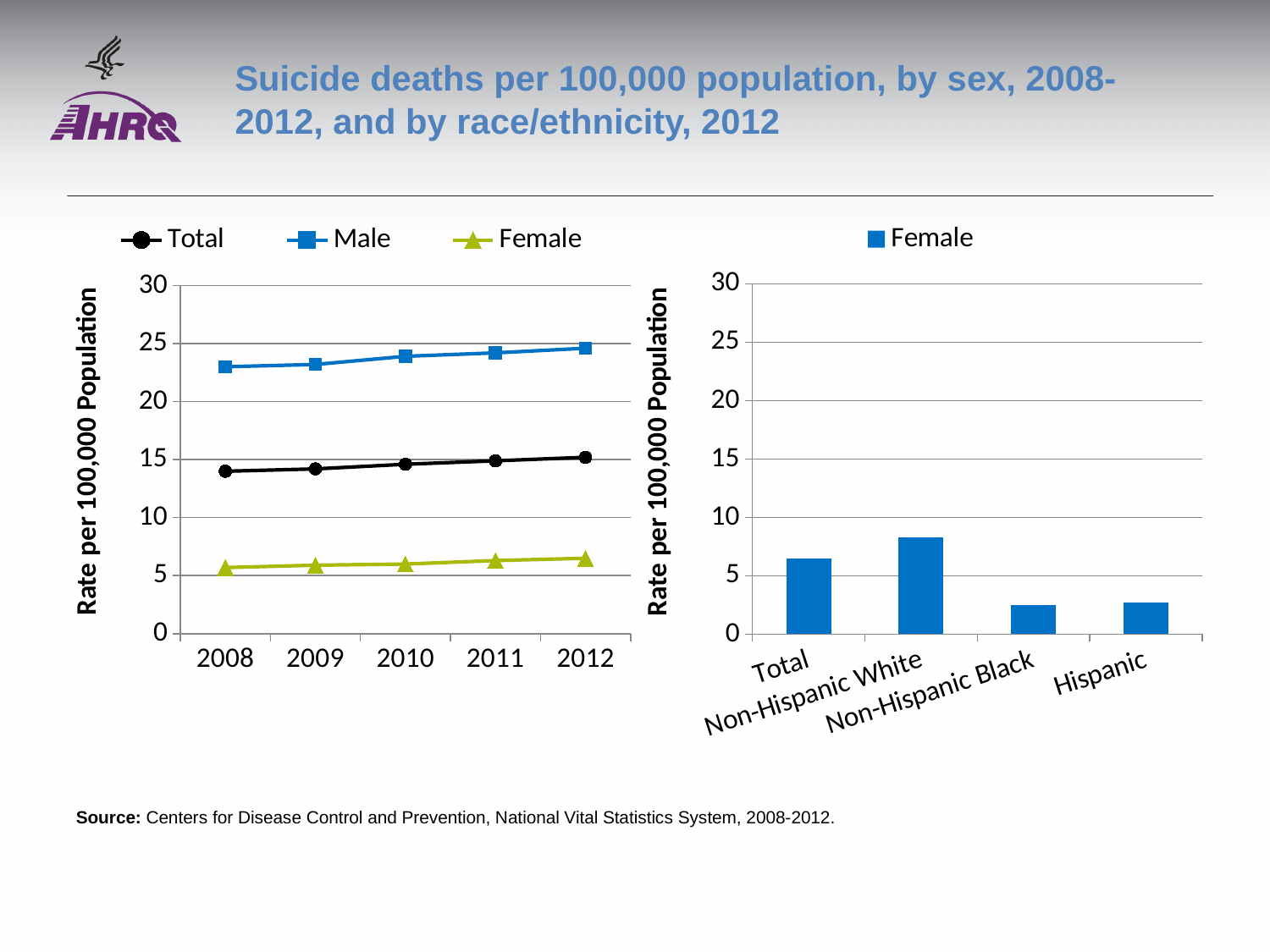
In the left chart, does the Male rate rise or fall from 2008 to 2012? rise In the left chart, which series has the lowest rate across all years? Female In the left chart, which series has the highest rate in 2012? Male What kind of chart is the right chart showing female suicide deaths by race/ethnicity, 2012? bar chart What kind of chart is the left chart showing suicide deaths by sex, 2008-2012? line chart How many race/ethnicity categories are shown in the right chart? 4 In the left chart, is the Male value for 2012 greater or less than 20? greater In the left chart, is the Total value for 2008 greater or less than 15? less In the right chart, which race/ethnicity group has the highest female suicide rate? Non-Hispanic White How many series does the legend of the left chart list? 3 How many years are plotted on the x axis of the left chart? 5 In the right chart, is the value for Non-Hispanic White greater or less than Total? greater